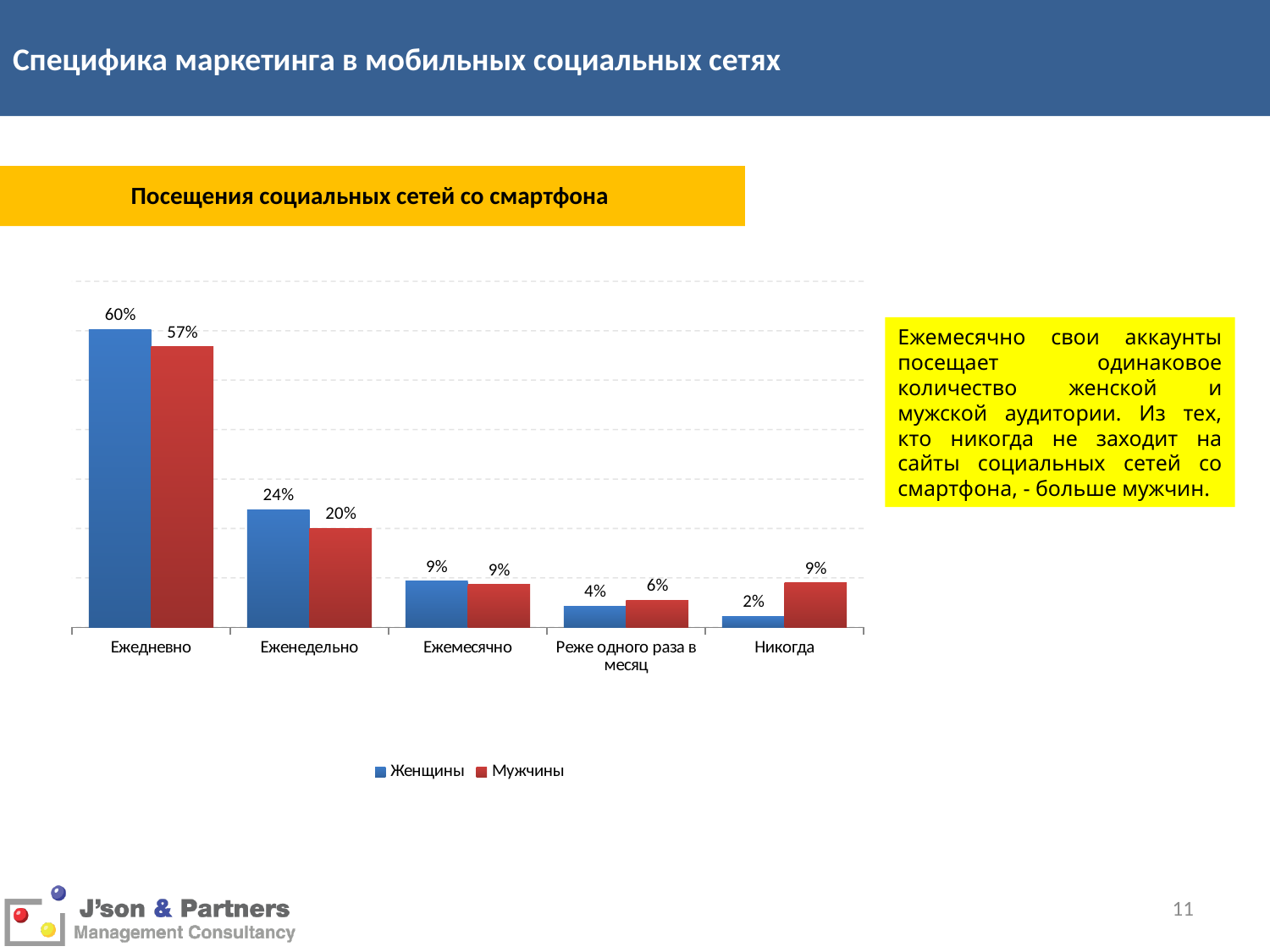
What is the value for Женщины in the Ежедневно category? 60% How many series does the legend list? 2 What is the value for Мужчины in the Еженедельно category? 20% How many categories are shown on the x axis? 5 What is the difference between the Женщины and Мужчины values in the Ежедневно category? 3% What is the value for Мужчины in the Никогда category? 9% Which category has the highest value for Женщины? Ежедневно What is the difference between the Женщины and Мужчины values in the Никогда category? 7% What is the title of the chart? Посещения социальных сетей со смартфона What kind of chart is shown on the slide? bar chart Which category has the lowest value for Женщины? Никогда In the Реже одного раза в месяц category, which is larger: Женщины or Мужчины? Мужчины